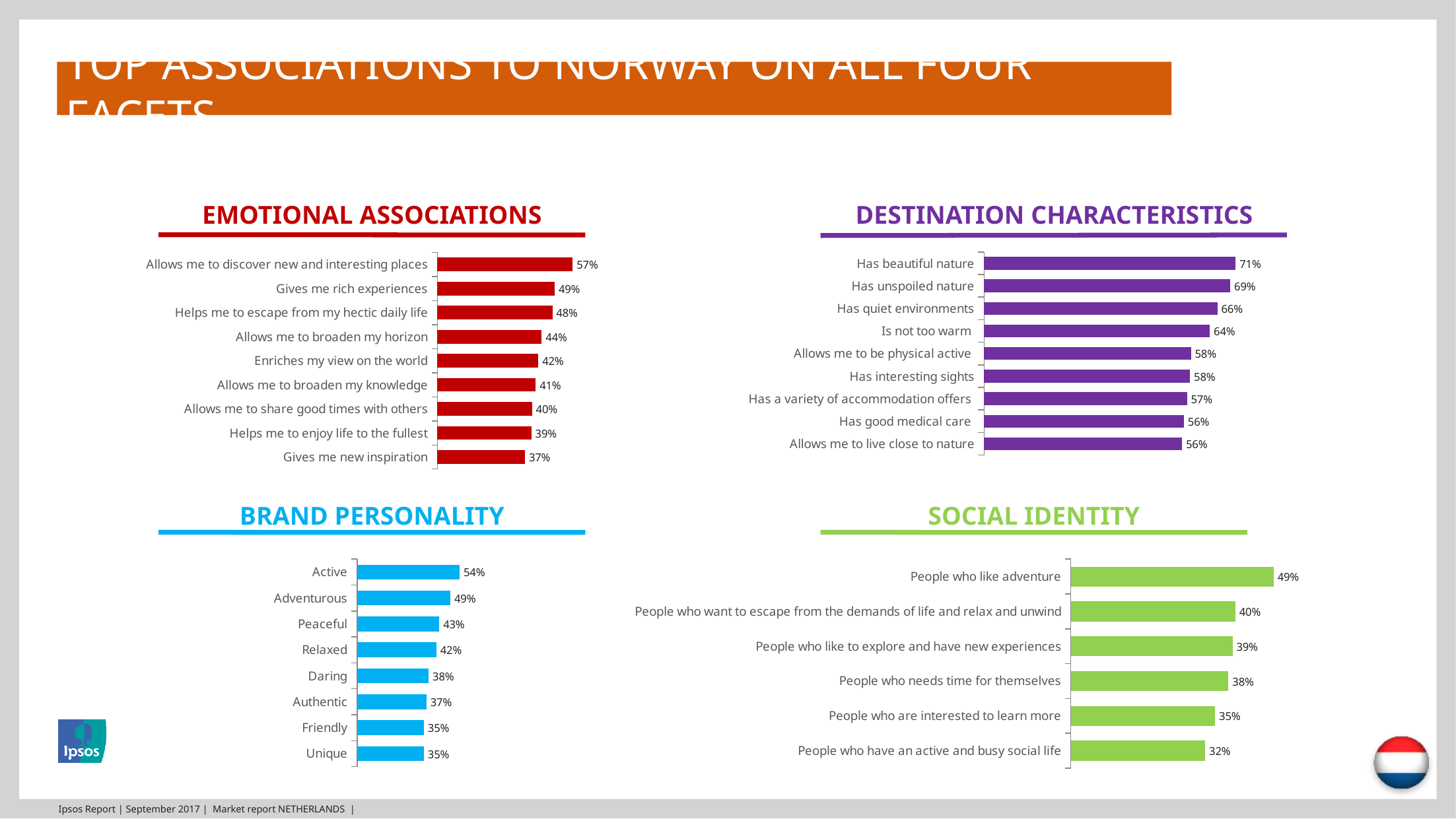
In the Destination Characteristics chart, which category has the highest value? Has beautiful nature How many categories are shown in the Destination Characteristics chart? 9 In the Destination Characteristics chart, what is the value for "Is not too warm"? 64% What type of chart is the Social Identity chart? Bar chart In the Social Identity chart, what is the difference between "People who like adventure" and "People who are interested to learn more"? 14% In the Social Identity chart, what is the value for "People who have an active and busy social life"? 32% In the Emotional Associations chart, what is the value for "Gives me rich experiences"? 49% In the Destination Characteristics chart, what is the difference between "Has beautiful nature" and "Has quiet environments"? 5% In the Brand Personality chart, which is larger, "Peaceful" or "Authentic"? Peaceful How many categories are shown in the Brand Personality chart? 8 In the Emotional Associations chart, which category has the lowest value? Gives me new inspiration In the Brand Personality chart, what is the value for "Daring"? 38%